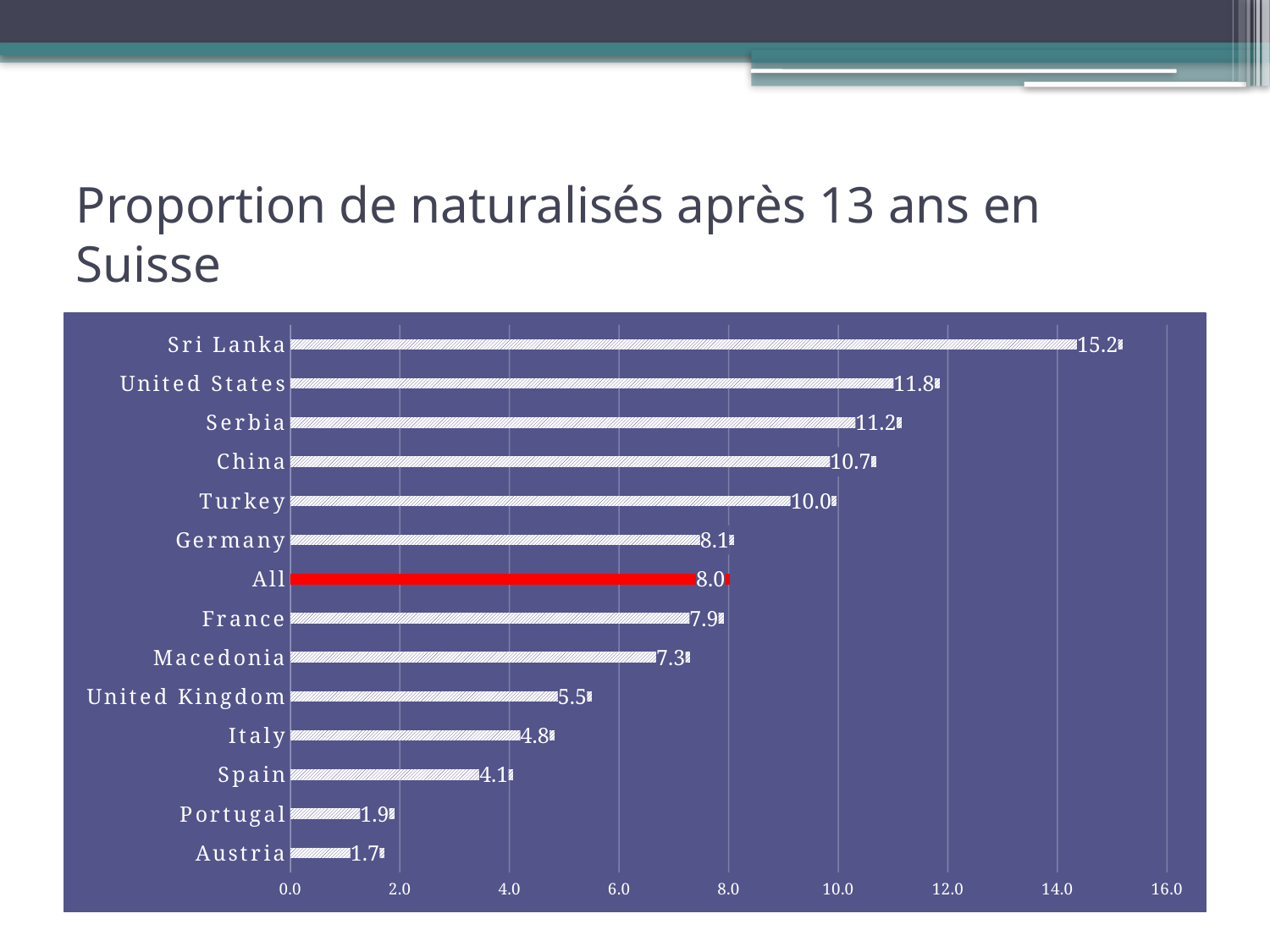
Which category has the lowest value? Austria What is the difference between the values for Portugal and Austria? 0.2 Is the value for Macedonia greater or less than 8.0? less What is the difference between the values for Sri Lanka and United States? 3.4 What is the value for Germany? 8.1 What kind of chart is shown on the slide? bar chart Which bar is highlighted in red? All What is the value for the 'All' category? 8.0 What is the value for Sri Lanka? 15.2 Which is larger, the value for Turkey or the value for China? China Which category has the highest value? Sri Lanka How many categories are shown in the chart? 14